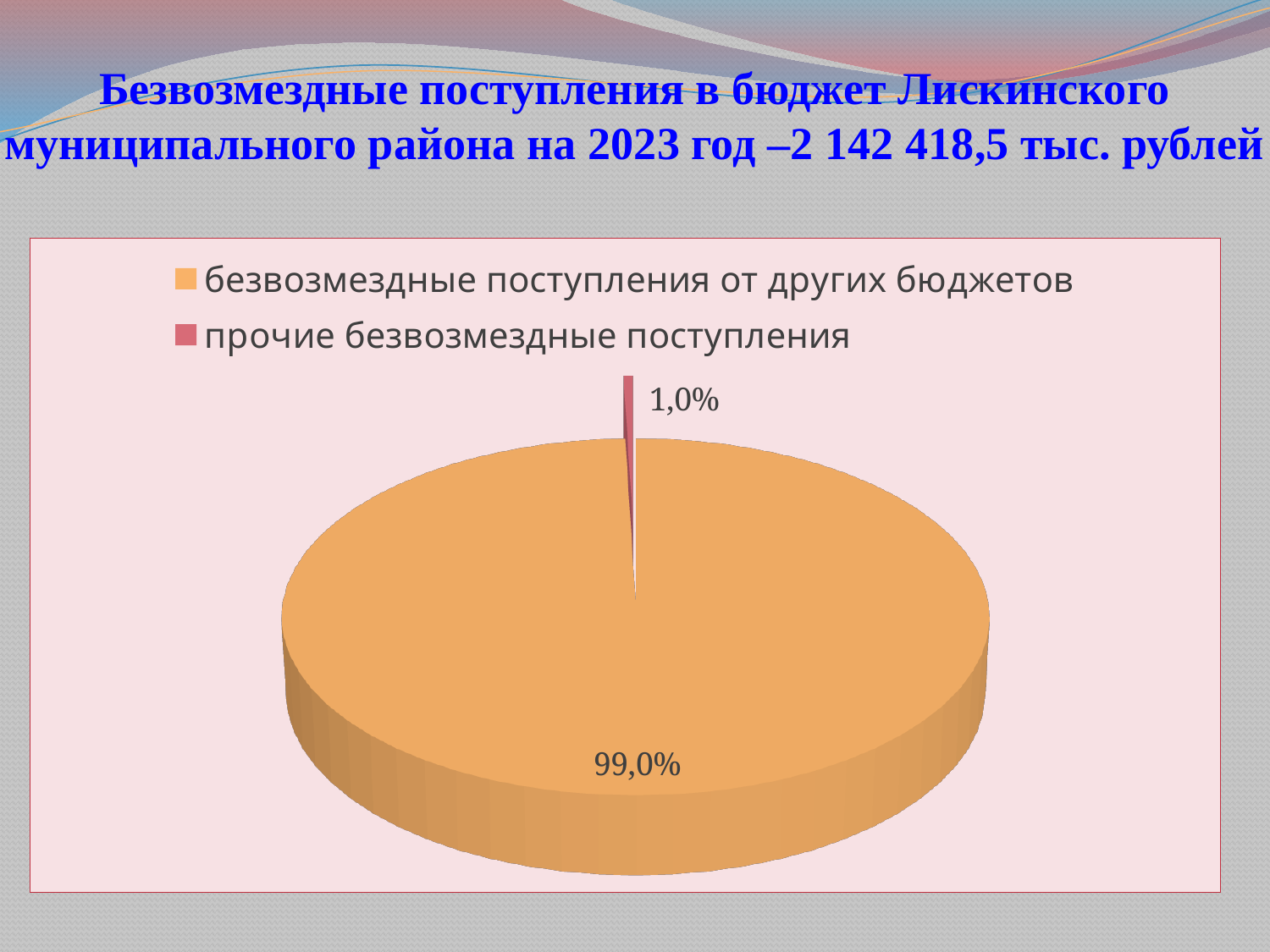
What colour is the slice for "прочие безвозмездные поступления"? red Which is larger: the slice for "безвозмездные поступления от других бюджетов" or the slice for "прочие безвозмездные поступления"? безвозмездные поступления от других бюджетов Which category has the smallest slice of the pie? прочие безвозмездные поступления How many slices does the pie chart have? 2 How many entries does the legend list? 2 Which category has the largest slice of the pie? безвозмездные поступления от других бюджетов What is the difference in percentage points between the two slices of the pie? 98,0% What kind of chart is shown on the slide? pie chart What share of the pie is labelled for "безвозмездные поступления от других бюджетов"? 99,0% What share of the pie is labelled for "прочие безвозмездные поступления"? 1,0% What total amount of gratuitous receipts for 2023 is stated in the slide title? 2 142 418,5 тыс. рублей